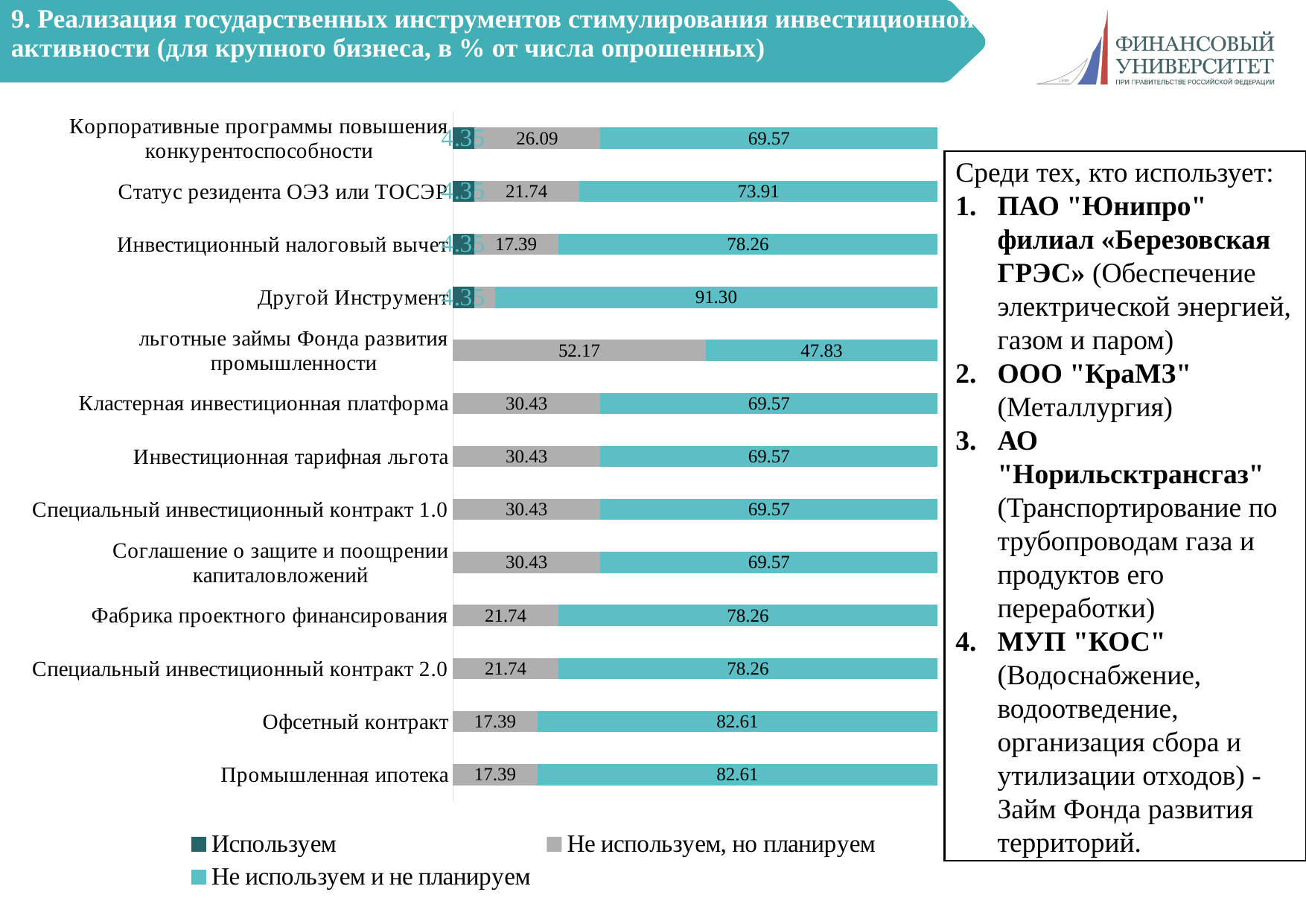
What is the value of "Не используем, но планируем" for "льготные займы Фонда развития промышленности"? 52.17 How many categories (instruments) are shown on the chart? 13 Which is larger: the "Не используем, но планируем" value for "Кластерная инвестиционная платформа" or for "Фабрика проектного финансирования"? Кластерная инвестиционная платформа What is the value of "Не используем и не планируем" for "Другой Инструмент"? 91.30 What is the difference between the "Не используем и не планируем" and "Не используем, но планируем" values for "Офсетный контракт"? 65.22 What kind of chart is shown on the slide? Stacked bar chart How many series does the legend list? 3 Which category has the highest value for "Не используем и не планируем"? Другой Инструмент What is the total of the stacked bar for "Промышленная ипотека"? 100.00 Which category has the lowest value for "Не используем и не планируем"? льготные займы Фонда развития промышленности What is the value of "Используем" for "Статус резидента ОЭЗ или ТОСЭР"? 4.35 Which category has the highest value for "Не используем, но планируем"? льготные займы Фонда развития промышленности